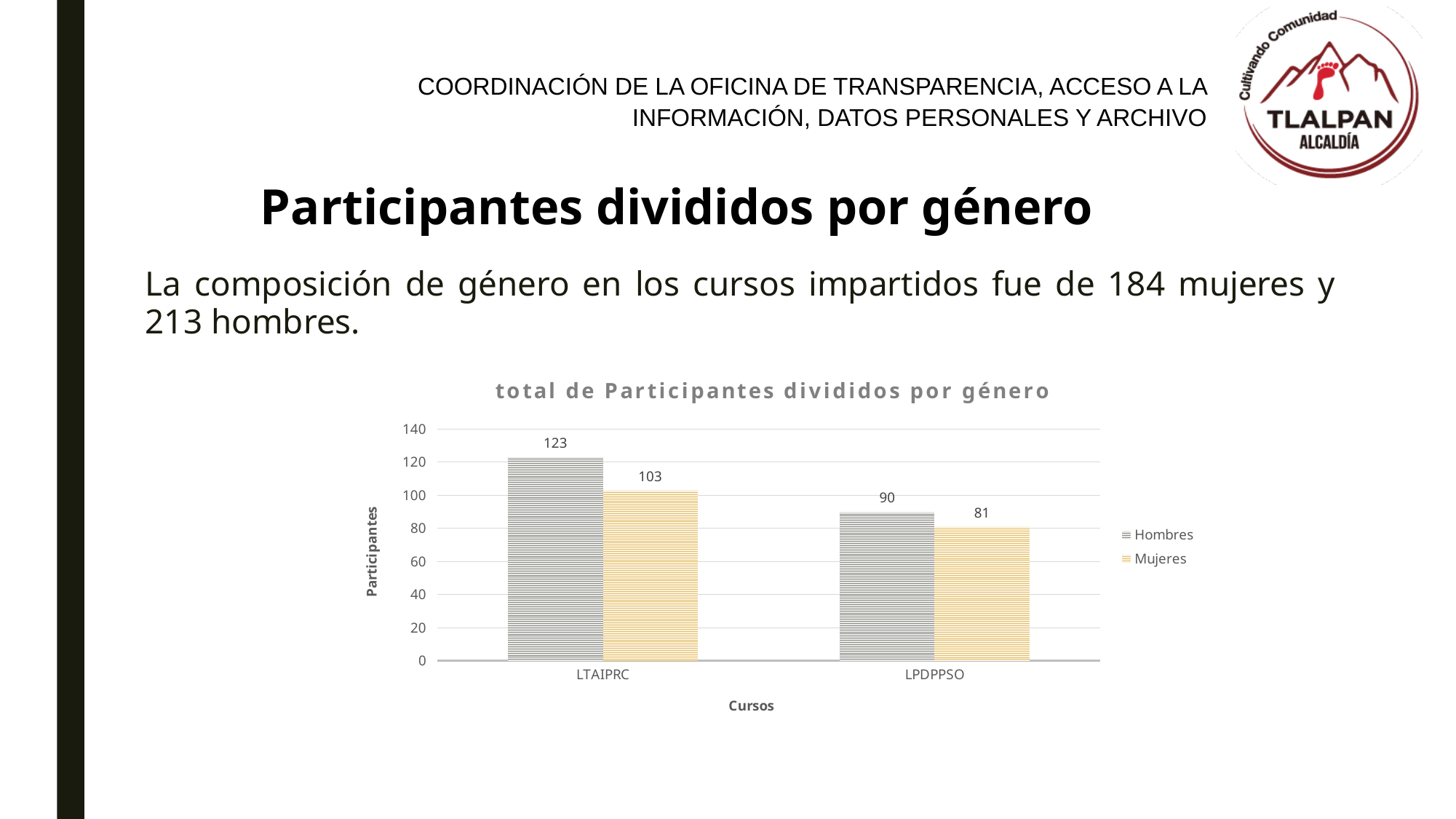
What is the value for Hombres in the LTAIPRC course? 123 How many series does the legend list? 2 What is the title of the chart? total de Participantes divididos por género Is the value for Hombres in LPDPPSO greater or less than 100? less What is the difference between Hombres and Mujeres in the LTAIPRC course? 20 Which course has the highest number of Hombres? LTAIPRC What is the value for Mujeres in the LPDPPSO course? 81 Which is larger: Hombres in LPDPPSO or Mujeres in LTAIPRC? Mujeres in LTAIPRC How many courses are shown on the x axis? 2 What is the value for Mujeres in the LTAIPRC course? 103 Which course has the lowest number of Mujeres? LPDPPSO What kind of chart is shown on the slide? Bar chart